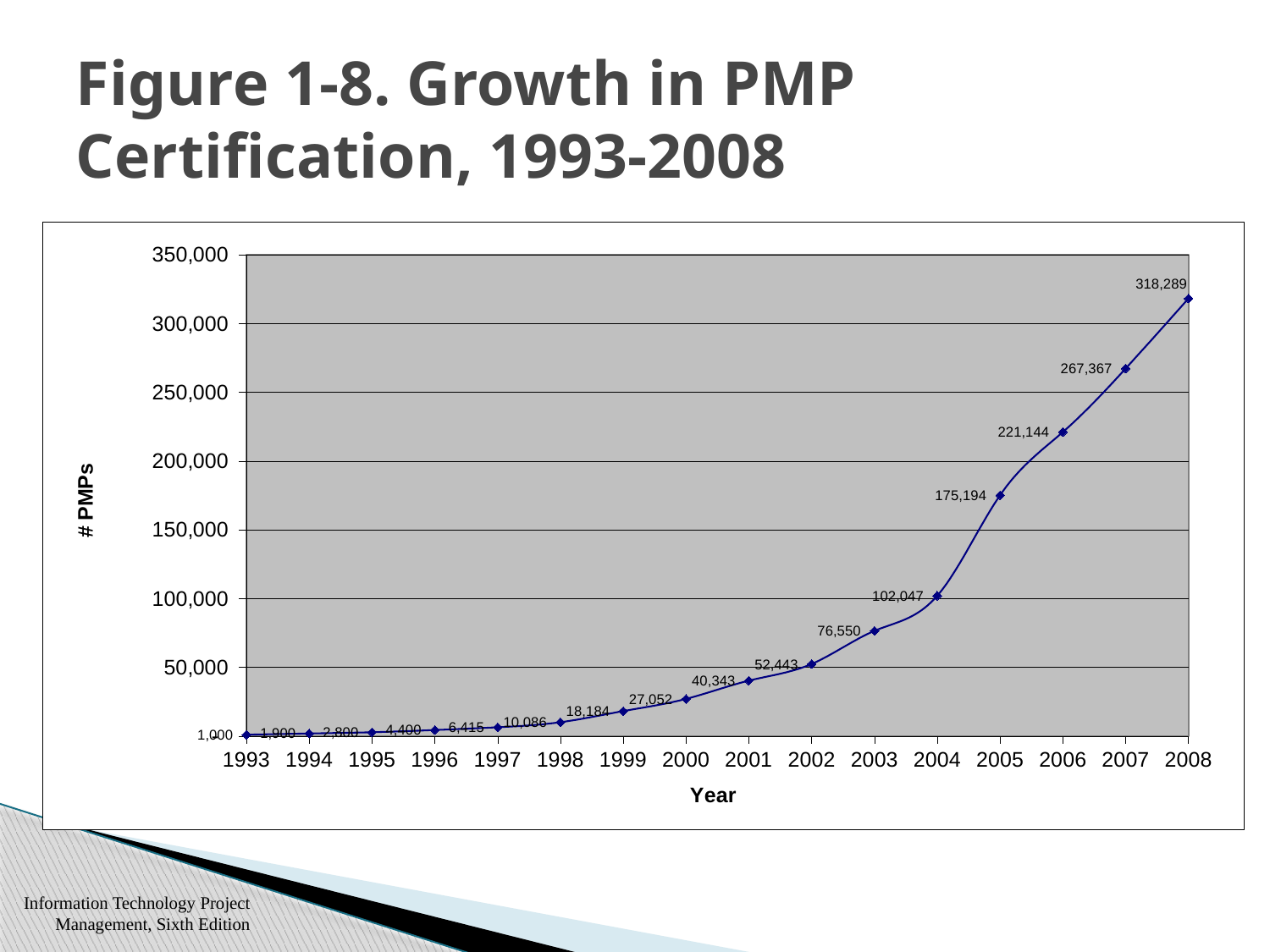
Do the values rise or fall from 1993 to 2008? Rise What is the number of PMPs in 2008? 318,289 What is the difference in the number of PMPs between 2005 and 2004? 73,147 What is the number of PMPs in 2000? 27,052 What kind of chart is shown on the slide? Line chart Which year has the lowest number of PMPs? 1993 What is the number of PMPs in 2004? 102,047 Which year has the highest number of PMPs? 2008 What is the difference in the number of PMPs between 2008 and 2007? 50,922 What is the number of PMPs in 2006? 221,144 How many years (data points) are plotted on the chart? 16 Which year has more PMPs, 2003 or 2005? 2005